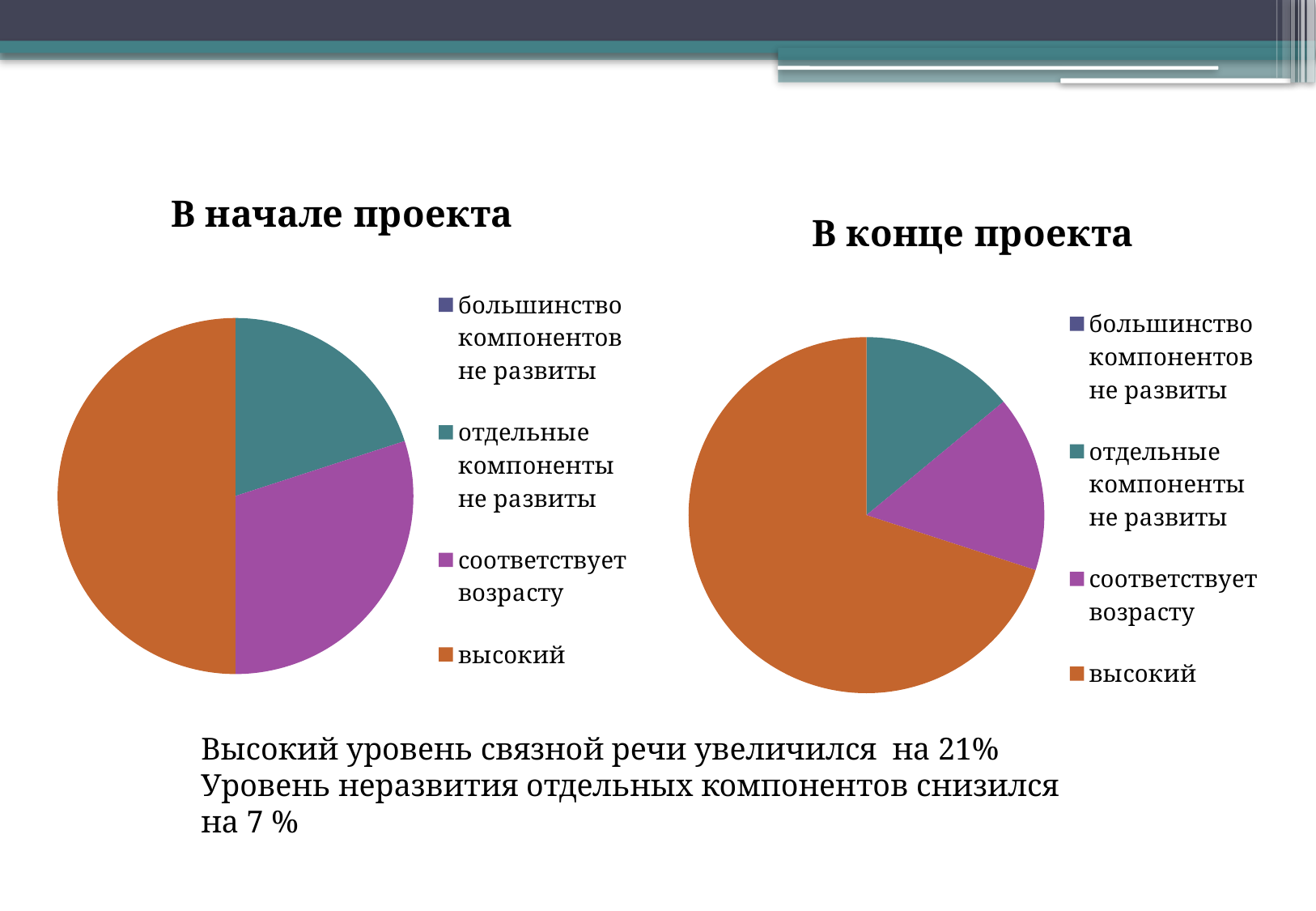
In the "В конце проекта" chart, which category has the largest slice? высокий What is the title of the chart on the left side of the slide? В начале проекта What kind of chart is shown under the title "В конце проекта"? pie chart Is the "высокий" slice larger in the "В начале проекта" chart or in the "В конце проекта" chart? В конце проекта In the "В конце проекта" chart, what colour represents the category "высокий"? orange How many entries does the legend of the "В конце проекта" chart list? 4 How many entries does the legend of the "В начале проекта" chart list? 4 Is the "отдельные компоненты не развиты" slice larger in the "В начале проекта" chart or in the "В конце проекта" chart? В начале проекта In the "В конце проекта" chart, which slice is larger: "отдельные компоненты не развиты" or "соответствует возрасту"? соответствует возрасту What kind of chart is shown under the title "В начале проекта"? pie chart In the "В начале проекта" chart, which category has the largest slice? высокий